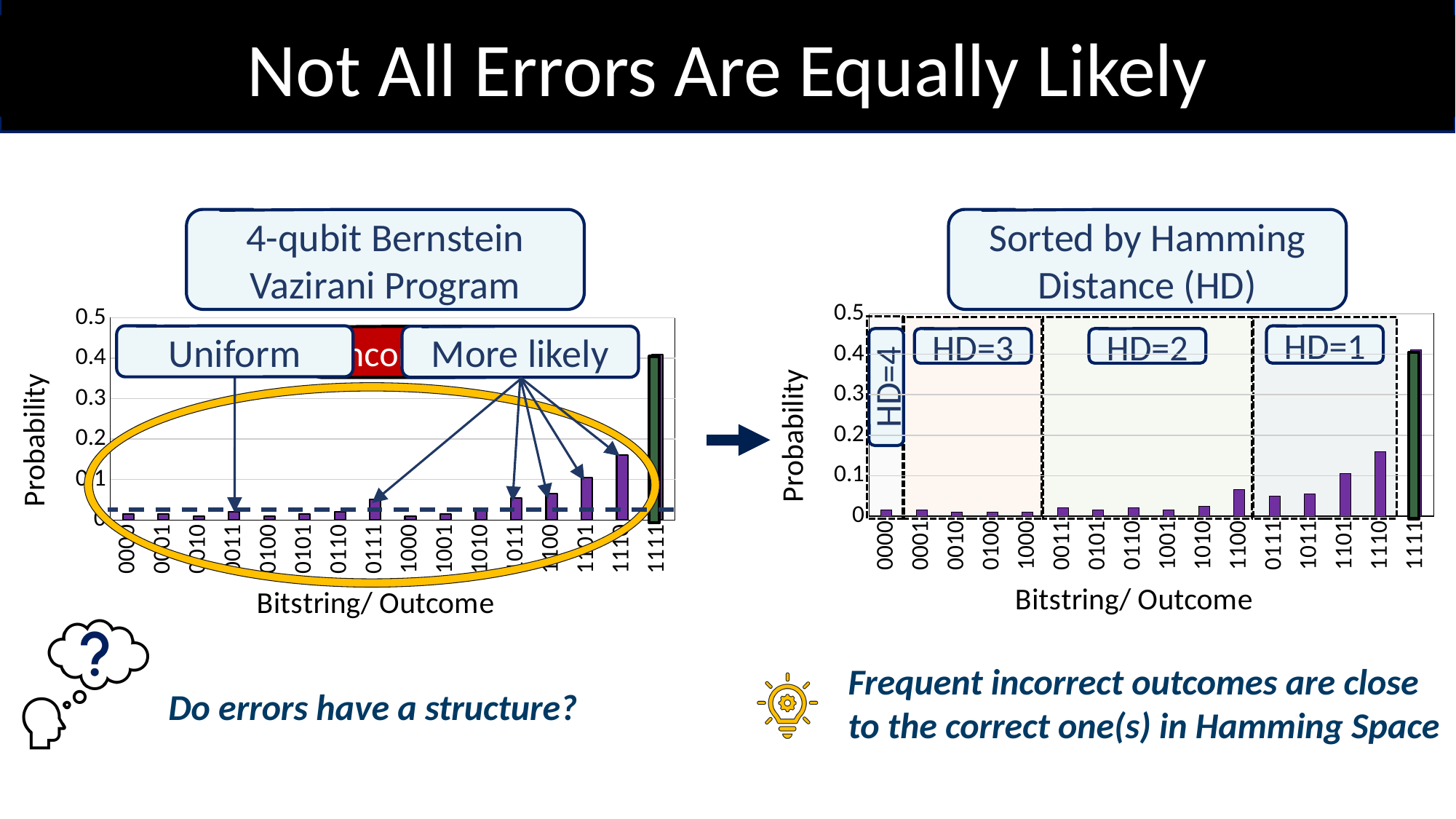
In the right chart 'Sorted by Hamming Distance (HD)', is the probability for 0000 greater or less than 0.1? less In the left chart '4-qubit Bernstein Vazirani Program', which bitstring has the highest probability? 1111 In the right chart 'Sorted by Hamming Distance (HD)', do the bar heights generally rise or fall from left to right along the x axis? rise What kind of chart is the left chart titled '4-qubit Bernstein Vazirani Program'? bar chart In the left chart '4-qubit Bernstein Vazirani Program', which has the higher probability, 1110 or 1011? 1110 In the left chart '4-qubit Bernstein Vazirani Program', how many bitstring categories are shown on the x axis? 16 What is the x-axis title of the right chart 'Sorted by Hamming Distance (HD)'? Bitstring/ Outcome In the right chart 'Sorted by Hamming Distance (HD)', which bitstring falls in the HD=4 group? 0000 In the left chart '4-qubit Bernstein Vazirani Program', is the probability for 1111 greater or less than 0.3? greater In the left chart '4-qubit Bernstein Vazirani Program', is the probability for 1110 greater or less than 0.1? greater In the right chart 'Sorted by Hamming Distance (HD)', which bitstring has the highest probability? 1111